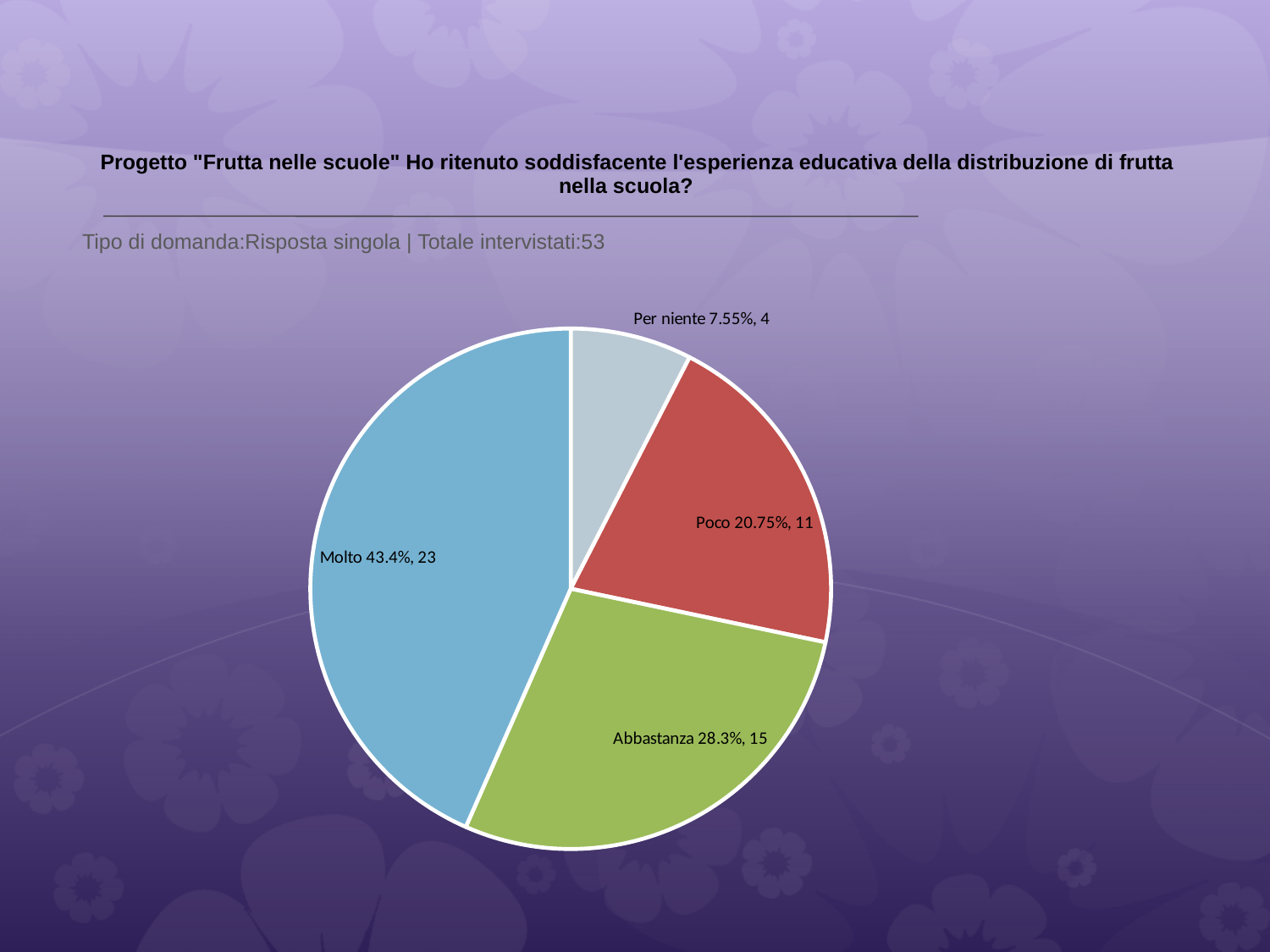
Which has more respondents, "Poco" or "Abbastanza"? Abbastanza What kind of chart is shown on the slide? pie chart What is the total number of respondents shown on the slide? 53 What colour is the "Molto" slice? blue Which category has the largest slice? Molto What percentage share does the "Molto" slice have? 43.4% Which category has the smallest slice? Per niente What percentage share does the "Abbastanza" slice have? 28.3% How many respondents answered "Per niente"? 4 What is the difference in respondent count between "Molto" and "Abbastanza"? 8 How many slices does the pie chart have? 4 How many respondents answered "Poco"? 11